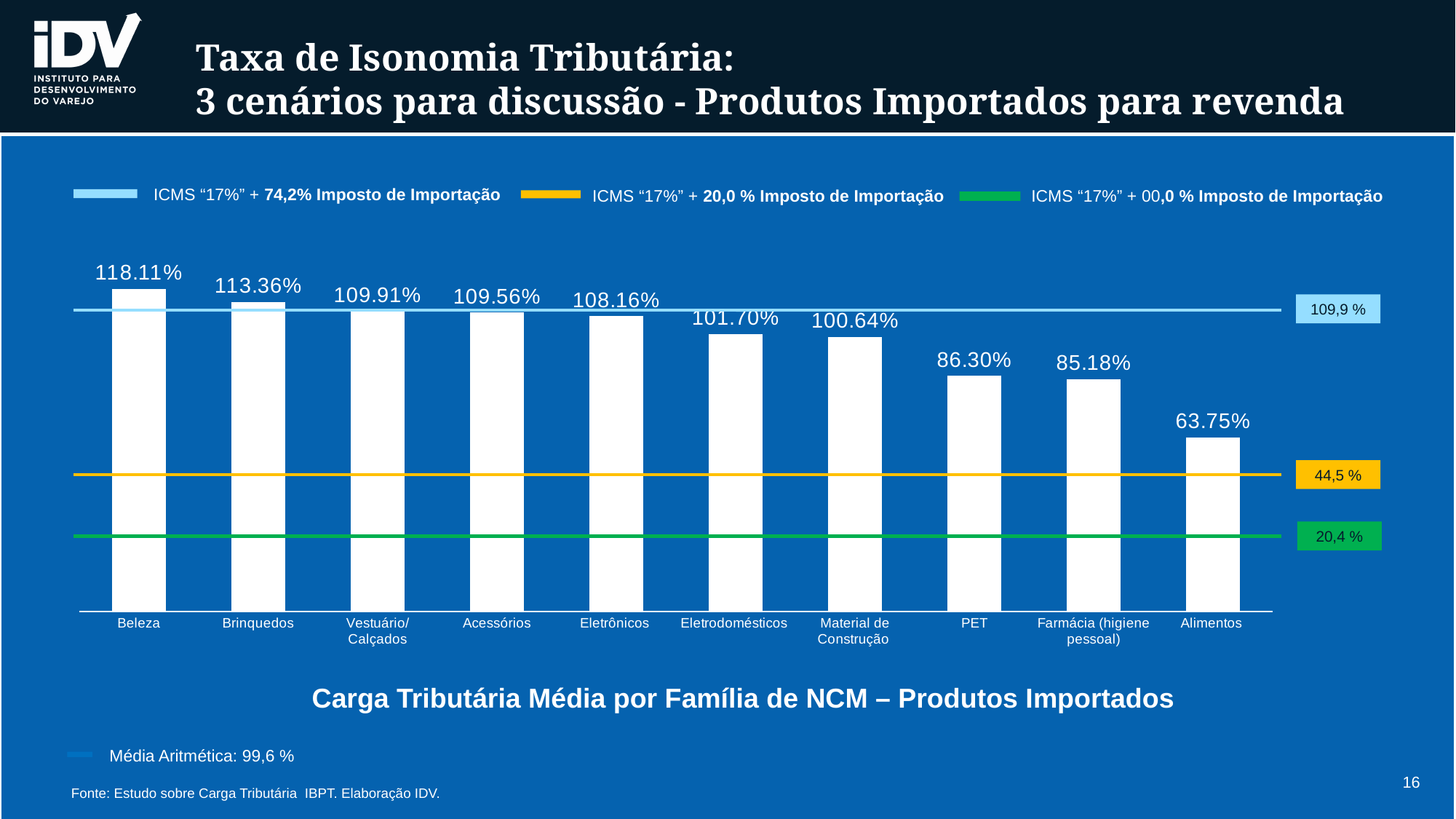
What kind of chart is shown on the slide? Bar chart What is the value shown for Farmácia (higiene pessoal)? 85.18% What value is labelled on the yellow horizontal reference line? 44,5 % What is the value shown for Material de Construção? 100.64% Do the bar values rise or fall from left to right along the x axis? Fall Which category has the highest value? Beleza How many categories are shown on the x axis? 10 What is the value shown for Beleza? 118.11% Which is larger, the value for Brinquedos or the value for PET? Brinquedos Which category has the lowest value? Alimentos What is the difference between the values for Beleza and Alimentos? 54.36 percentage points How many entries does the legend at the top of the chart list? 3